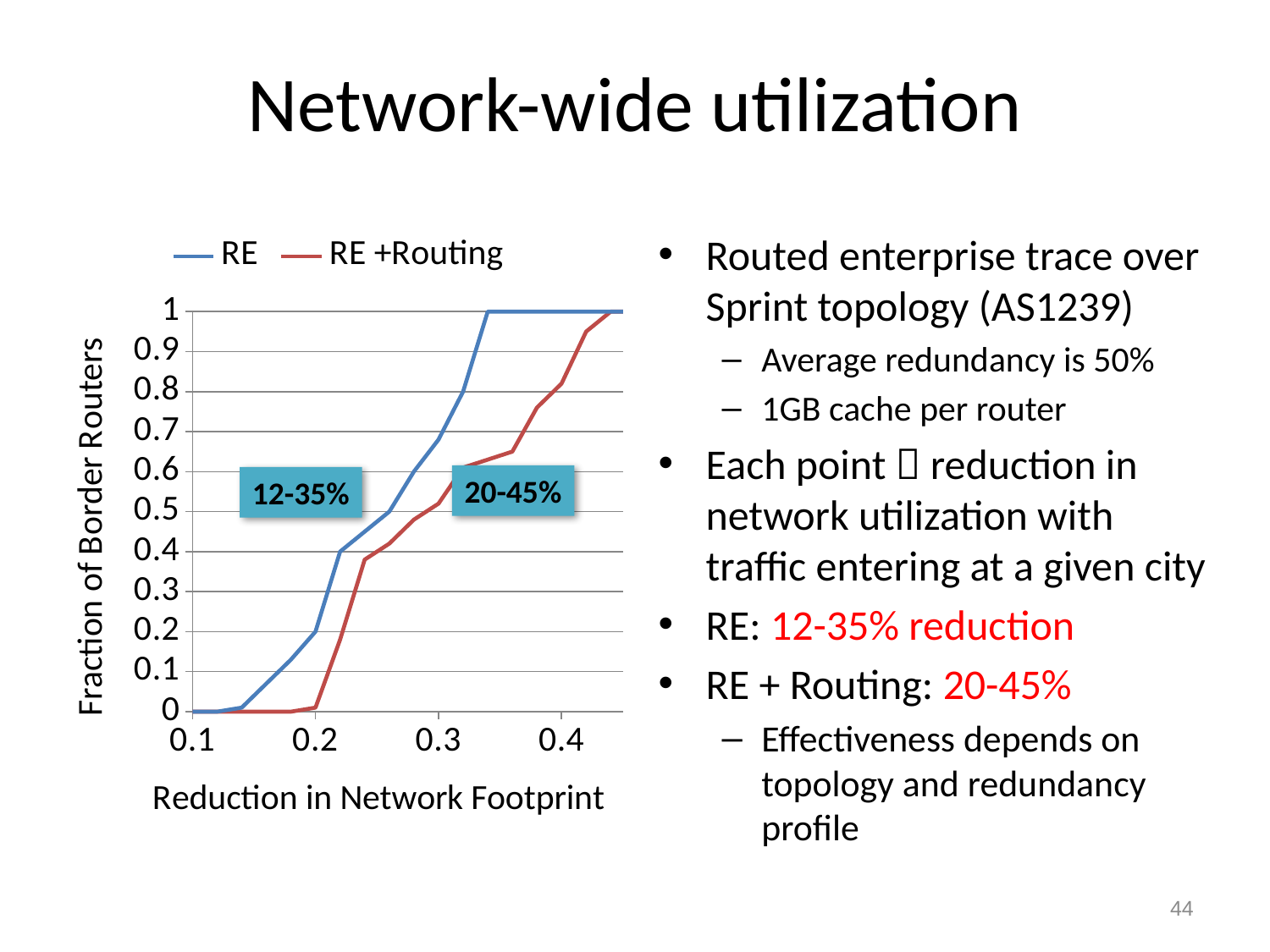
At a reduction in network footprint of 0.2, is the RE +Routing series value greater or less than 0.1? less At a reduction in network footprint of 0.3, is the RE series value greater or less than 0.5? greater At a reduction in network footprint of 0.4, which series has the higher fraction of border routers, RE or RE +Routing? RE Do the values of the RE series rise or fall as the reduction in network footprint increases? rise What kind of chart is shown on the slide? line chart Which two series are listed in the chart legend? RE and RE +Routing Which series reaches a fraction of border routers of 1 at a smaller reduction in network footprint, RE or RE +Routing? RE At a reduction in network footprint of 0.3, which series has the higher fraction of border routers, RE or RE +Routing? RE Do the values of the RE +Routing series rise or fall along the x axis? rise At a reduction in network footprint of 0.4, is the RE +Routing series value greater or less than 0.7? greater What is the title of the chart's x axis? Reduction in Network Footprint How many series does the chart legend list? 2